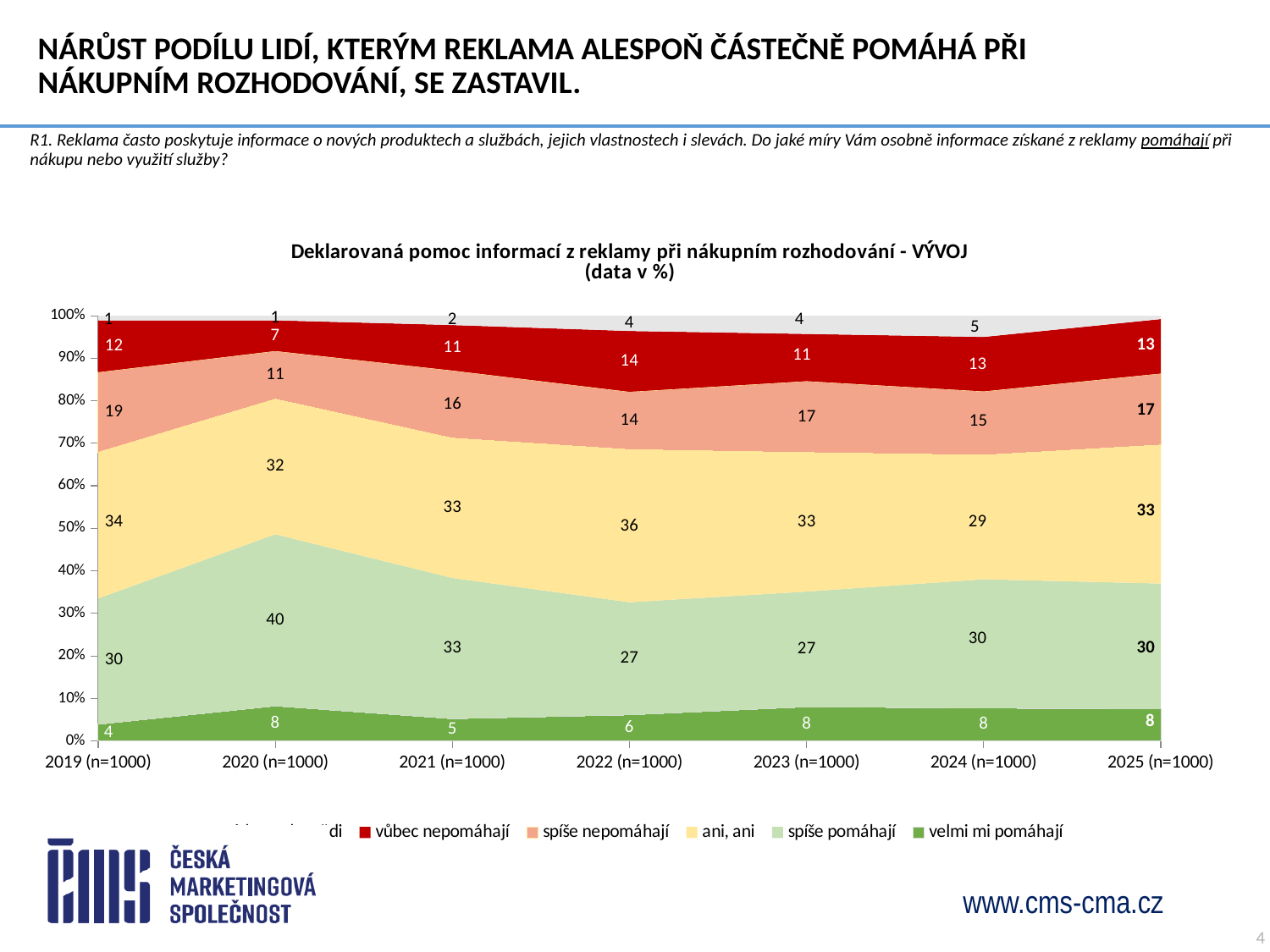
What kind of chart is shown on the slide? Area chart What is the value for 'velmi mi pomáhají' in 2021 (n=1000)? 5 Which year has the larger value for 'ani, ani': 2022 (n=1000) or 2024 (n=1000)? 2022 (n=1000) What is the value for 'spíše pomáhají' in 2020 (n=1000)? 40 Does the value for 'ani, ani' rise or fall from 2022 (n=1000) to 2024 (n=1000)? Fall What is the title of the chart? Deklarovaná pomoc informací z reklamy při nákupním rozhodování - VÝVOJ (data v %) In which year is the value for 'spíše pomáhají' the highest? 2020 (n=1000) What is the difference between the 'spíše nepomáhají' values in 2019 (n=1000) and 2020 (n=1000)? 8 In which year is the value for 'velmi mi pomáhají' the lowest? 2019 (n=1000) What is the value for 'vůbec nepomáhají' in 2022 (n=1000)? 14 What is the value for 'ani, ani' in 2025 (n=1000)? 33 How many years are shown on the x axis of the chart? 7